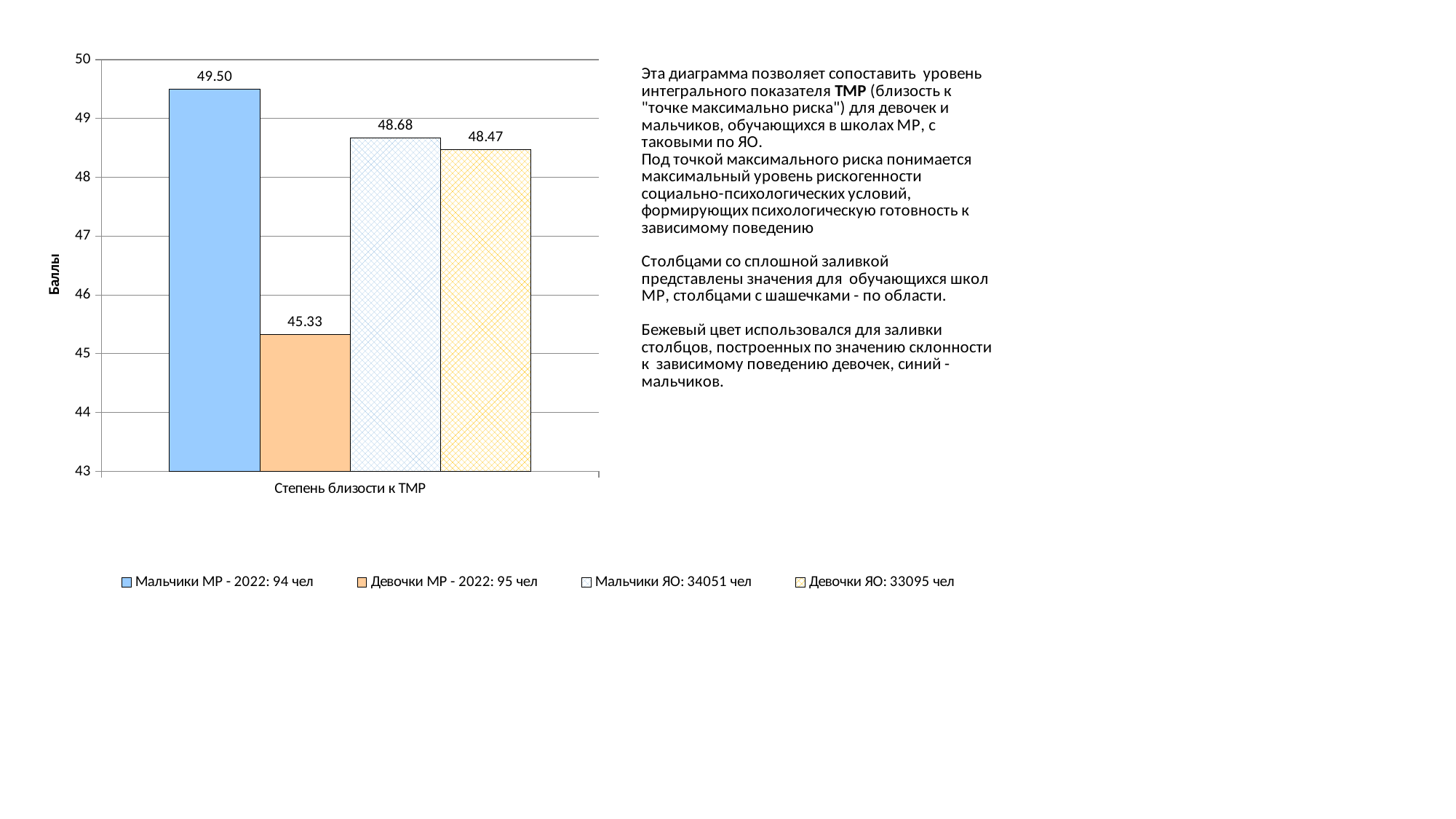
What is the value for Мальчики МР - 2022: 94 чел? 49.50 What is the label of the vertical axis? Баллы How many series does the legend list? 4 What is the value for Девочки ЯО: 33095 чел? 48.47 What is the difference between the values for Мальчики МР - 2022: 94 чел and Девочки МР - 2022: 95 чел? 4.17 What is the value for Девочки МР - 2022: 95 чел? 45.33 What kind of chart is shown on the slide? bar chart Which is larger, the value for Мальчики ЯО: 34051 чел or the value for Девочки МР - 2022: 95 чел? Мальчики ЯО: 34051 чел What is the value for Мальчики ЯО: 34051 чел? 48.68 Which series has the highest value? Мальчики МР - 2022: 94 чел Is the value for Девочки МР - 2022: 95 чел greater or less than 46? less Which series has the lowest value? Девочки МР - 2022: 95 чел